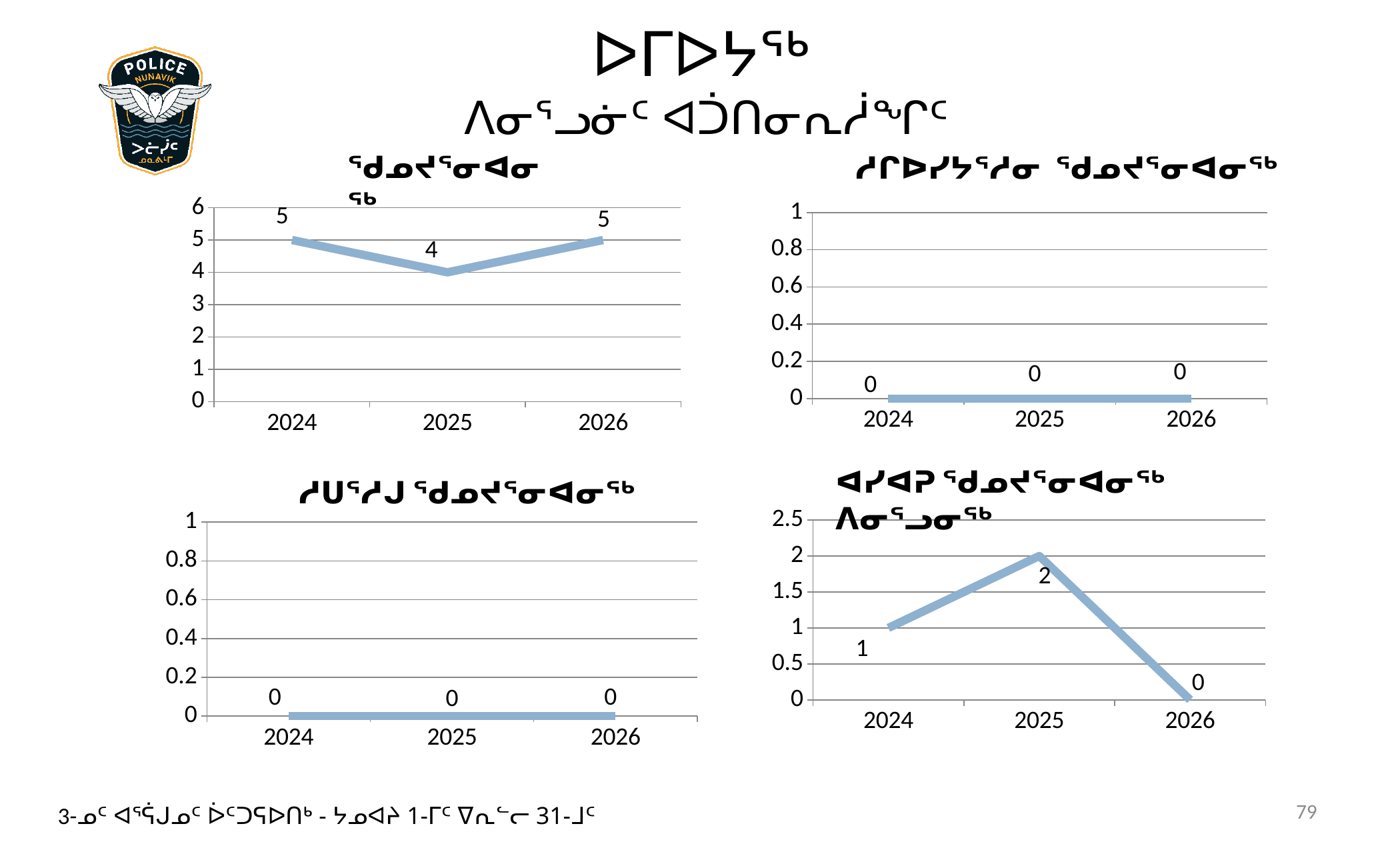
In the top-left chart, how many data points are plotted? 3 In the top-left chart, which year has the lowest value? 2025 In the bottom-right chart, is the value for 2024 or 2026 larger? 2024 In the bottom-right chart, what is the value for 2025? 2 In the bottom-right chart, what is the difference between the values for 2025 and 2024? 1 In the bottom-right chart, which year has the highest value? 2025 What kind of chart is the top-left chart? line chart In the bottom-left chart, what is the value for 2025? 0 In the top-left chart, what is the value for 2025? 4 In the top-right chart, what is the value for 2026? 0 In the top-left chart, what is the value for 2024? 5 In the top-left chart, what is the difference between the values for 2024 and 2025? 1